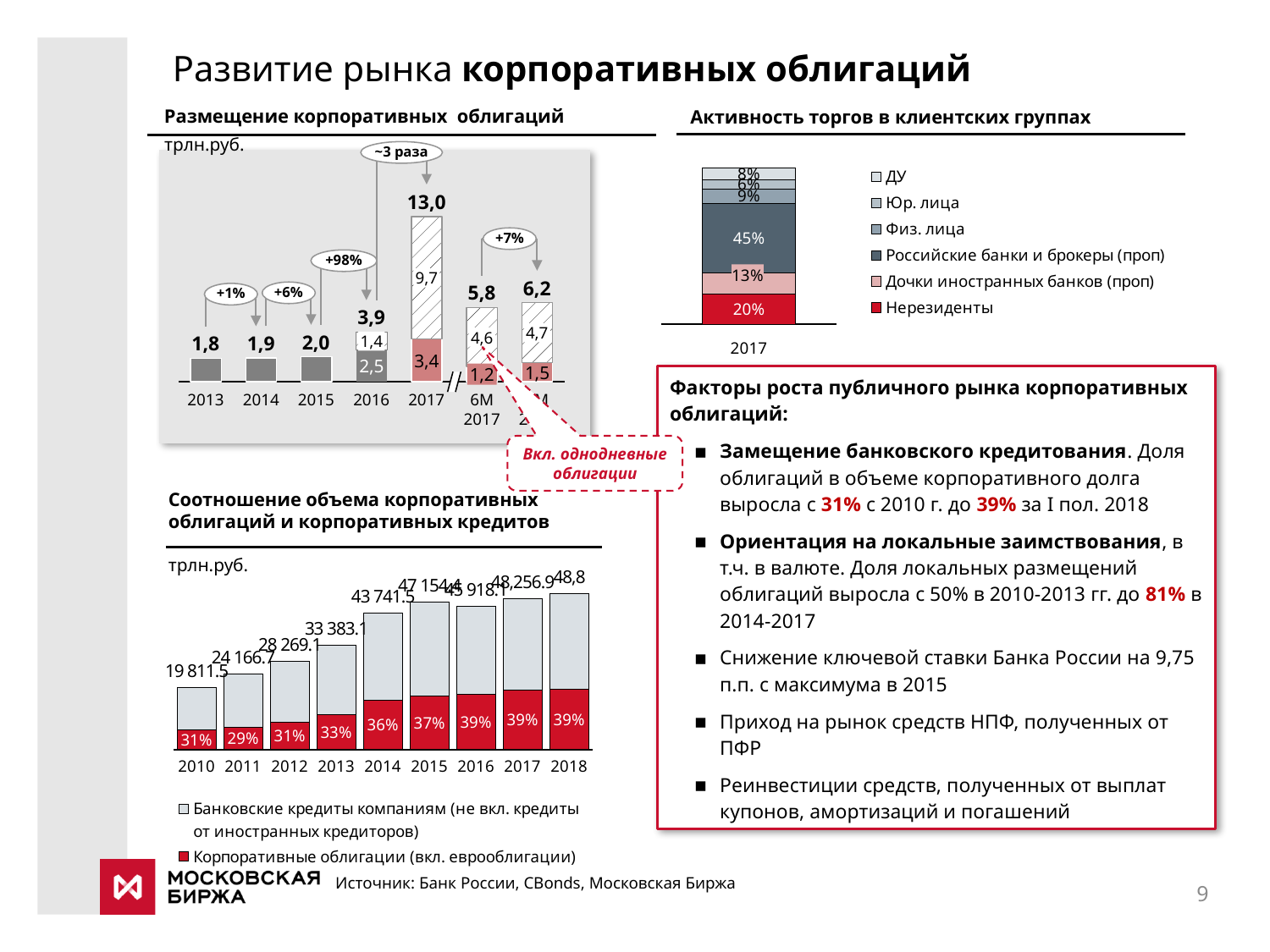
In the chart 'Активность торгов в клиентских группах', what share do 'Российские банки и брокеры (проп)' have? 45% In the chart 'Размещение корпоративных облигаций', what is the value for 2013? 1,8 In the chart 'Размещение корпоративных облигаций', what growth percentage is shown between 2015 and 2016? +98% In the chart 'Размещение корпоративных облигаций', what is the total value for 2017? 13,0 In the chart 'Соотношение объема корпоративных облигаций и корпоративных кредитов', how many years are shown on the x axis? 9 In the chart 'Размещение корпоративных облигаций', which year has the highest total value? 2017 In the chart 'Размещение корпоративных облигаций', what is the difference between the 2015 and 2014 values? 0,1 In the chart 'Активность торгов в клиентских группах', what share do 'Нерезиденты' have? 20% In the chart 'Соотношение объема корпоративных облигаций и корпоративных кредитов', what is the total value for 2014? 43 741.5 In the chart 'Соотношение объема корпоративных облигаций и корпоративных кредитов', what is the share of corporate bonds in 2010? 31% In the chart 'Размещение корпоративных облигаций', what is the total value for 6M 2017? 5,8 How many client groups does the legend of the chart 'Активность торгов в клиентских группах' list? 6